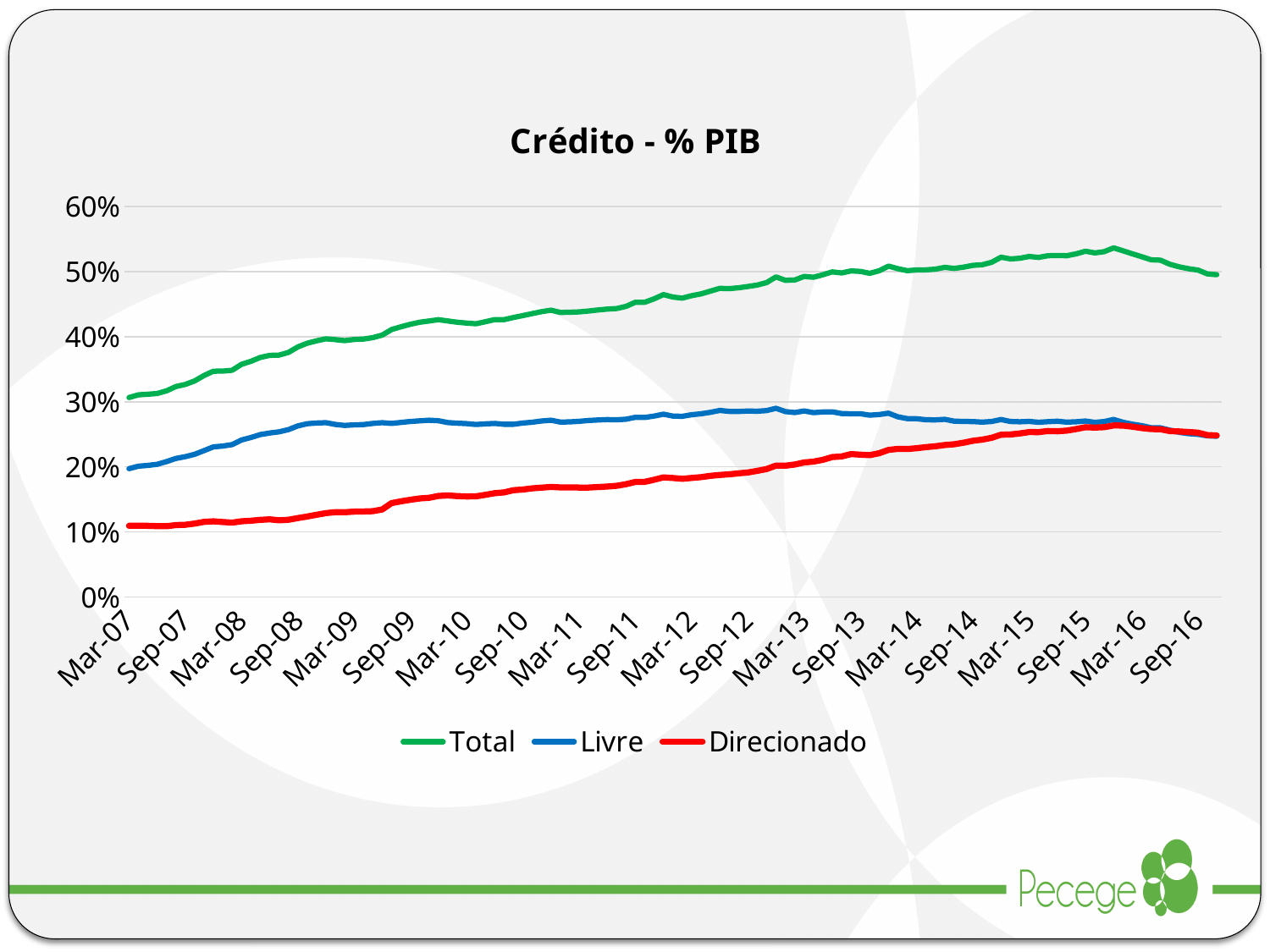
Is the value of Total at Mar-10 greater or less than 40%? greater Does the Direcionado series generally rise or fall from Mar-07 to Sep-15? Rise What is the title of the chart? Crédito - % PIB Is the value of Total at Mar-16 greater or less than 50%? greater What kind of chart is shown on the slide? Line chart Which series has the highest values throughout the chart? Total At Mar-07, which is larger: Livre or Direcionado? Livre Is the value of Direcionado at Mar-10 greater or less than 20%? less How many series does the legend list? 3 Which series is plotted in red? Direcionado How many date labels are shown on the x axis? 20